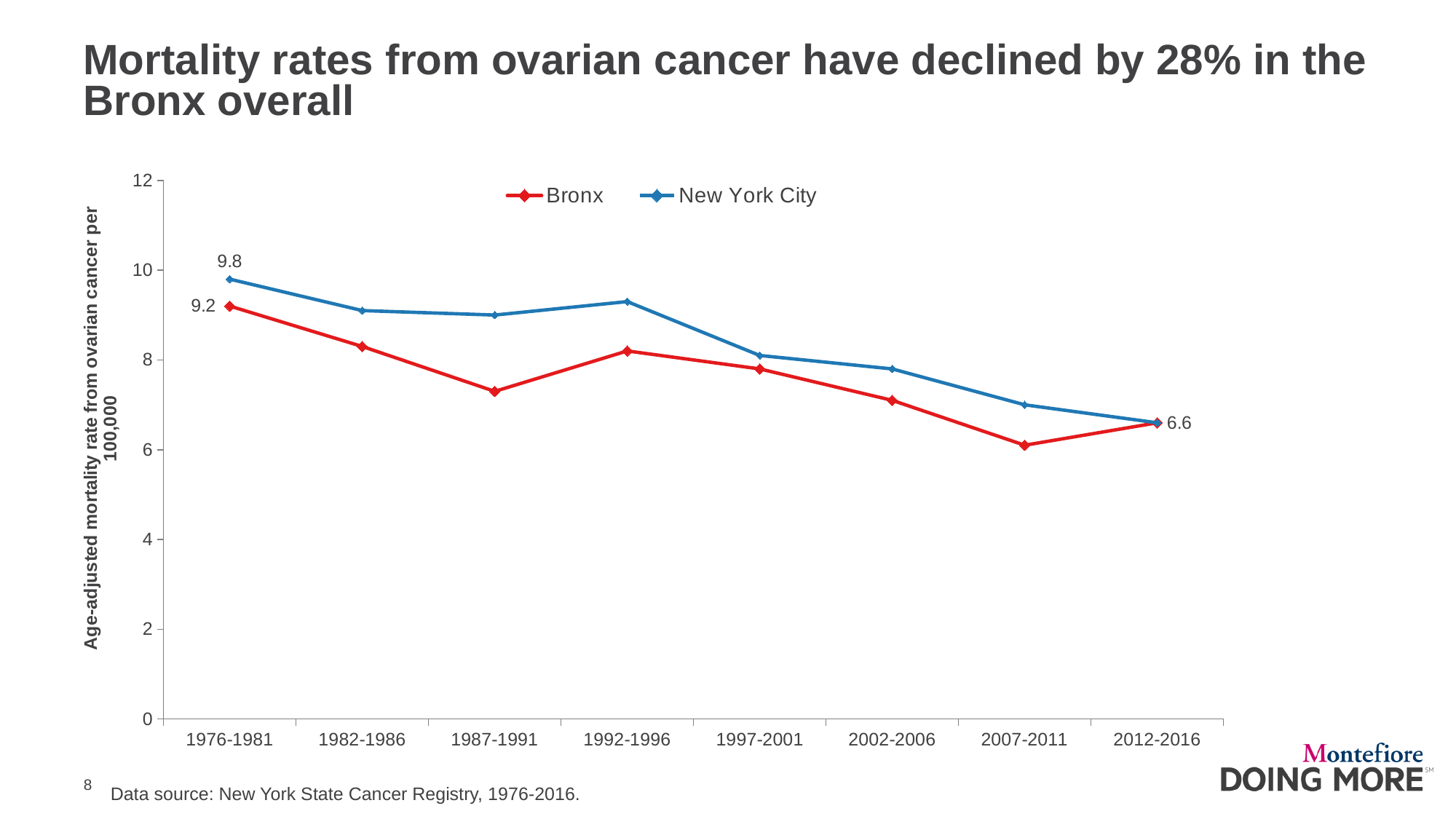
What is the age-adjusted mortality rate for the Bronx in 1976-1981? 9.2 What colour is the line for the Bronx series? red In 1976-1981, which series has the higher mortality rate, Bronx or New York City? New York City By how much did the Bronx mortality rate fall from 1976-1981 to 2012-2016? 2.6 In 1976-1981, how much higher is the New York City rate than the Bronx rate? 0.6 Is the value for the Bronx in 2007-2011 greater or less than 8? less How many series does the legend list? 2 What kind of chart is shown on the slide? line chart Overall, does the Bronx mortality rate rise or fall from 1976-1981 to 2012-2016? fall What is the age-adjusted mortality rate for the Bronx in 2012-2016? 6.6 How many time periods are shown on the x axis? 8 What is the age-adjusted mortality rate for New York City in 1976-1981? 9.8